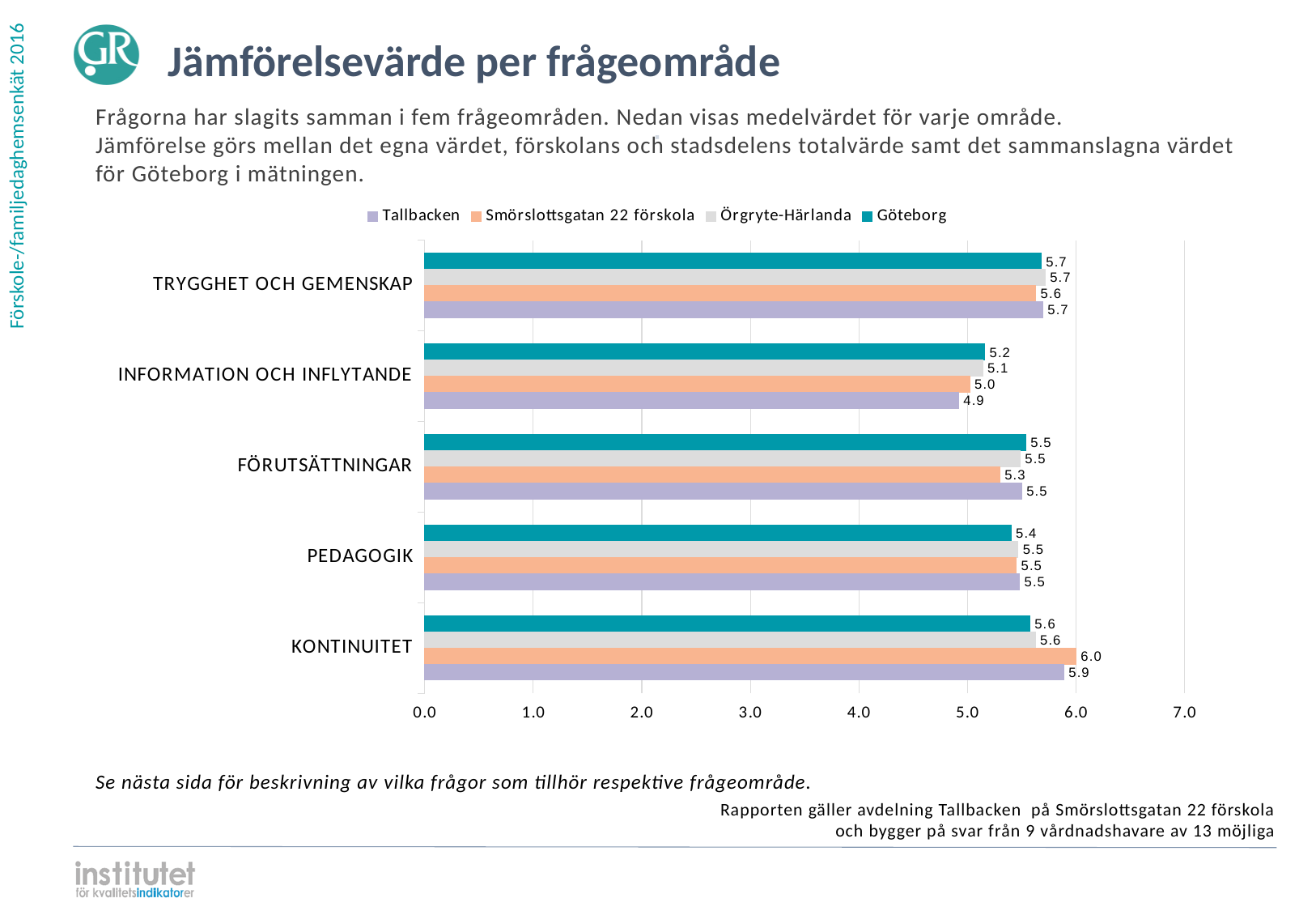
What is the Örgryte-Härlanda value for FÖRUTSÄTTNINGAR? 5.5 How many series does the legend list? 4 What is the Göteborg value for PEDAGOGIK? 5.4 What is the Tallbacken value for INFORMATION OCH INFLYTANDE? 4.9 Which category has the highest Smörslottsgatan 22 förskola value? KONTINUITET How many question areas (categories) are shown on the chart? 5 What is the difference between the Tallbacken value and the Göteborg value for INFORMATION OCH INFLYTANDE? 0.3 For KONTINUITET, which is larger: the Smörslottsgatan 22 förskola value or the Göteborg value? Smörslottsgatan 22 förskola What is the Smörslottsgatan 22 förskola value for KONTINUITET? 6.0 What kind of chart is shown on the slide? Bar chart Which category has the lowest Tallbacken value? INFORMATION OCH INFLYTANDE What is the maximum value shown on the horizontal axis? 7.0